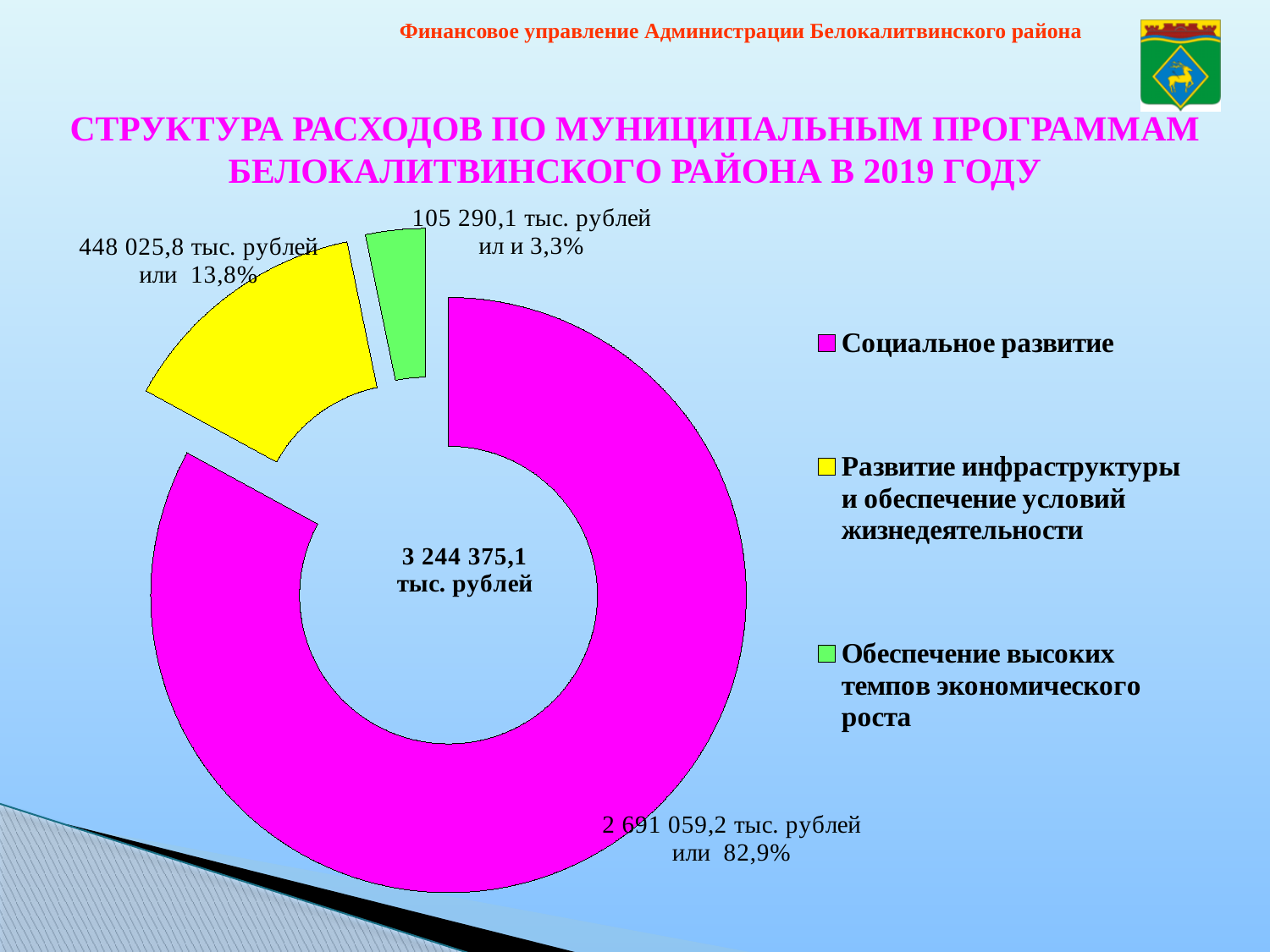
Какая программа имеет наименьшую сумму расходов? Обеспечение высоких темпов экономического роста Какова сумма расходов по программе «Обеспечение высоких темпов экономического роста»? 105 290,1 тыс. рублей Сколько категорий (секторов) показано на диаграмме? 3 Какую долю расходов занимает программа «Обеспечение высоких темпов экономического роста»? 3,3% Какова сумма расходов по программе «Развитие инфраструктуры и обеспечение условий жизнедеятельности»? 448 025,8 тыс. рублей Сколько элементов перечислено в легенде диаграммы? 3 Какова общая сумма расходов по муниципальным программам, указанная в центре диаграммы? 3 244 375,1 тыс. рублей Какая программа имеет наибольшую сумму расходов? Социальное развитие Какую долю расходов занимает программа «Социальное развитие»? 82,9% На сколько тыс. рублей расходы по программе «Развитие инфраструктуры и обеспечение условий жизнедеятельности» больше расходов по программе «Обеспечение высоких темпов экономического роста»? 342 735,7 тыс. рублей Какой тип диаграммы показан на слайде? кольцевая диаграмма Какова сумма расходов по программе «Социальное развитие»? 2 691 059,2 тыс. рублей